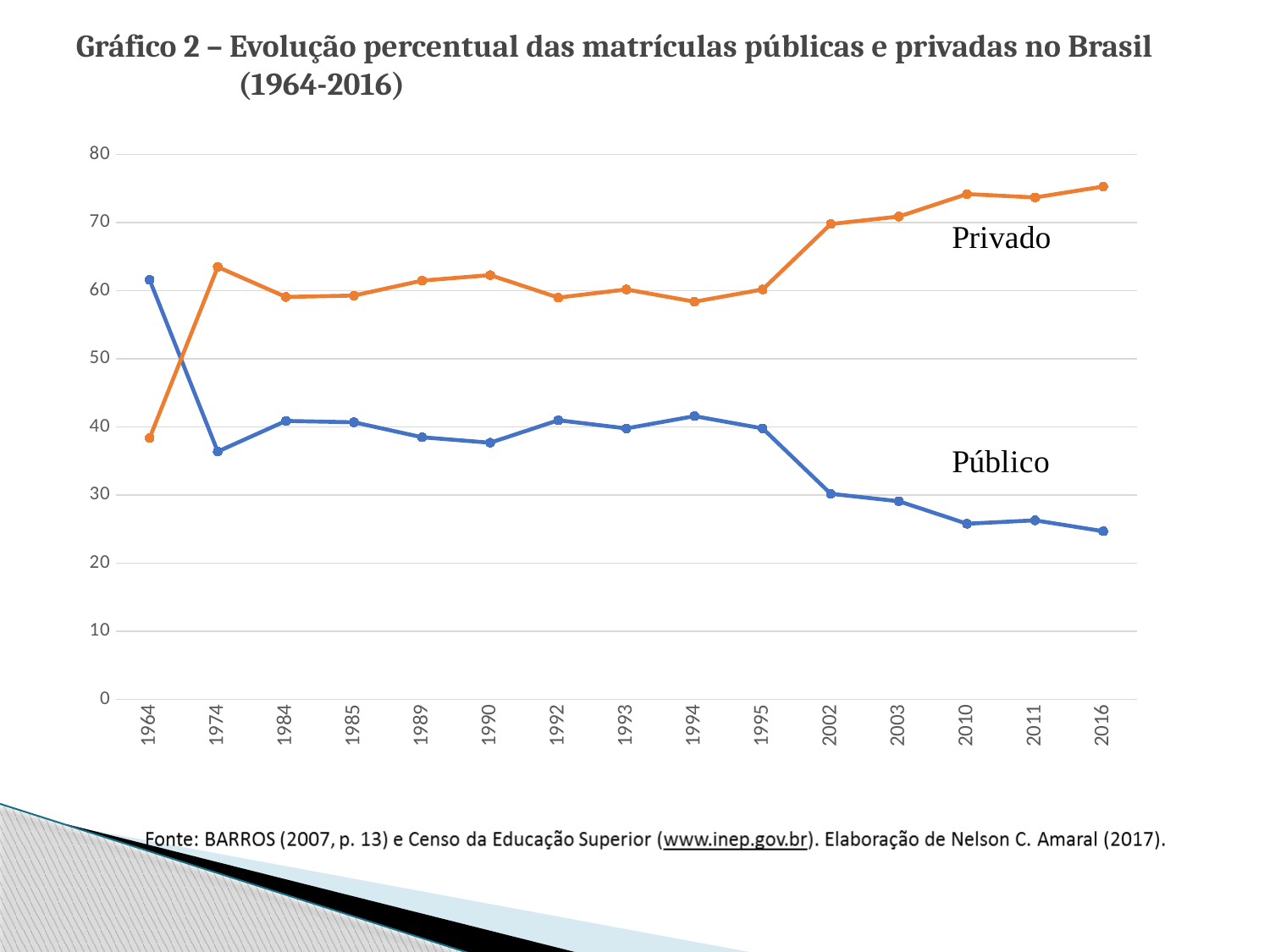
In 2016, which series has the larger value, Privado or Público? Privado What kind of chart is shown on the slide? line chart In which year does the Público series reach its lowest value? 2016 In which year does the Privado series reach its lowest value? 1964 In 1964, which series has the larger value, Privado or Público? Público How many series are plotted on the chart? 2 In which year does the Privado series reach its highest value? 2016 How many years are shown along the x axis of the chart? 15 Is the value for Privado in 2016 greater or less than 70? greater Does the Público series generally rise or fall from 1964 to 2016? fall Is the value for Público in 2010 greater or less than 30? less In which year does the Público series reach its highest value? 1964